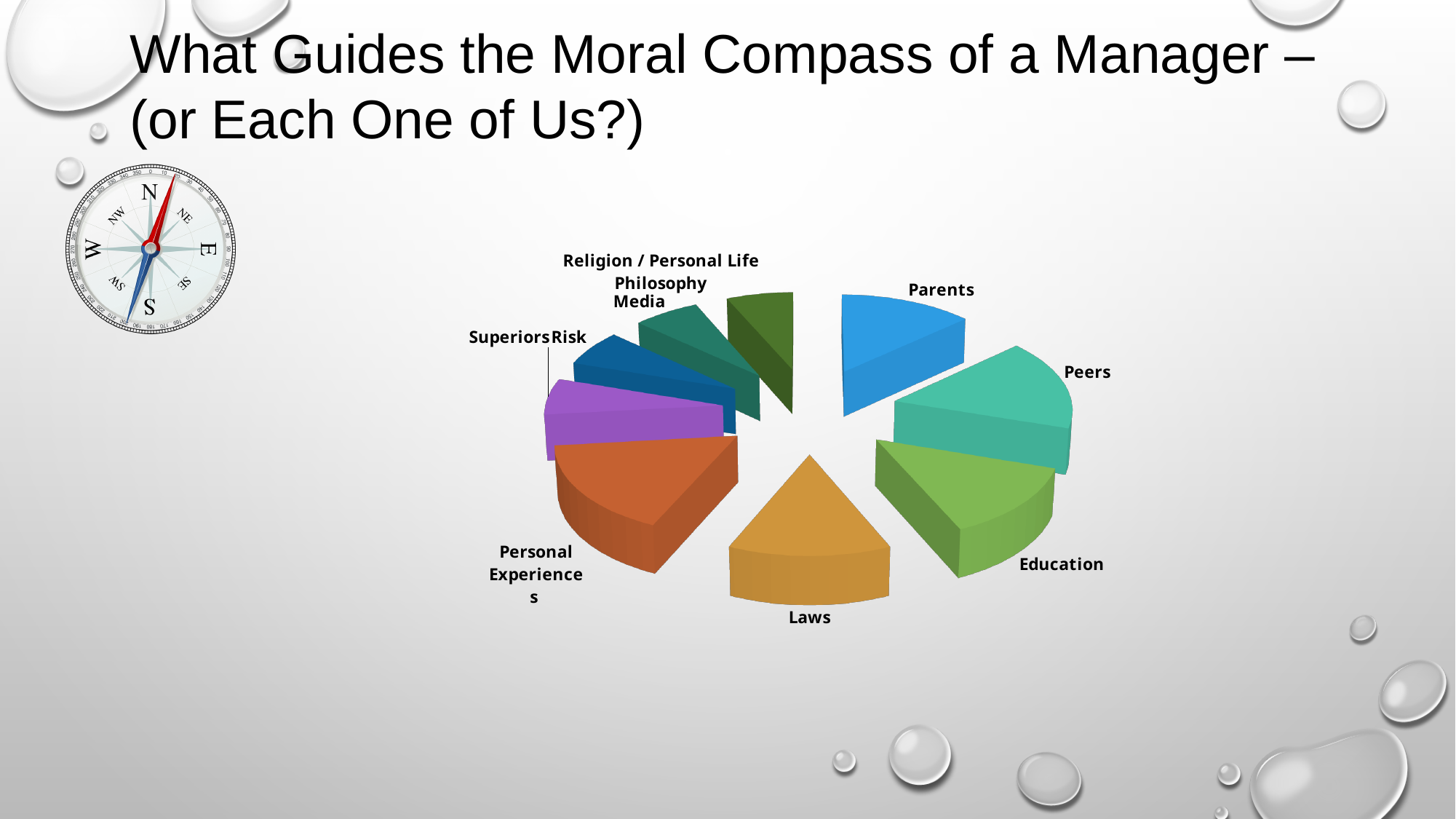
Which is larger in the pie chart, the Education slice or the Superiors slice? Education What colour is the Parents slice in the pie chart? blue Which is larger in the pie chart, the Peers slice or the Risk slice? Peers Which is larger in the pie chart, the Personal Experiences slice or the Media slice? Personal Experiences What kind of chart is shown on the slide? pie chart How many slices does the pie chart have? 9 Which slice of the pie chart is purple? Superiors